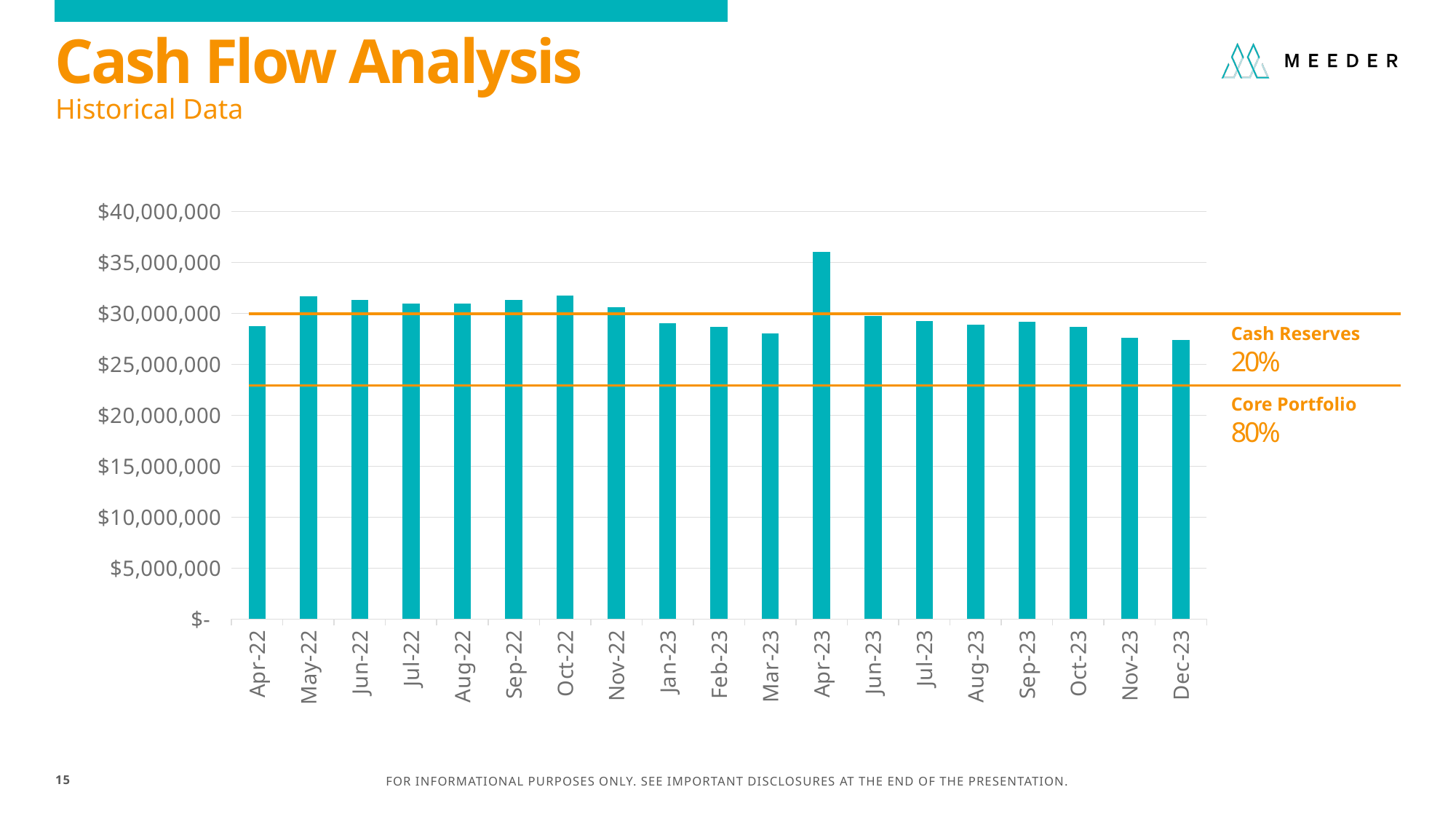
What kind of chart is shown on the slide? bar chart Is the value for May-22 greater or less than $30,000,000? greater How many months (bars) are plotted on the chart? 19 Is the value for Apr-23 greater or less than $35,000,000? greater Is the value for Apr-22 greater or less than $30,000,000? less Which is larger, the value for Oct-22 or the value for Dec-23? Oct-22 Which month has the highest value on the chart? Apr-23 What percentage is shown for Cash Reserves on the chart? 20% Which is larger, the value for Apr-23 or the value for Apr-22? Apr-23 Do the values rise or fall from Oct-23 to Dec-23? fall